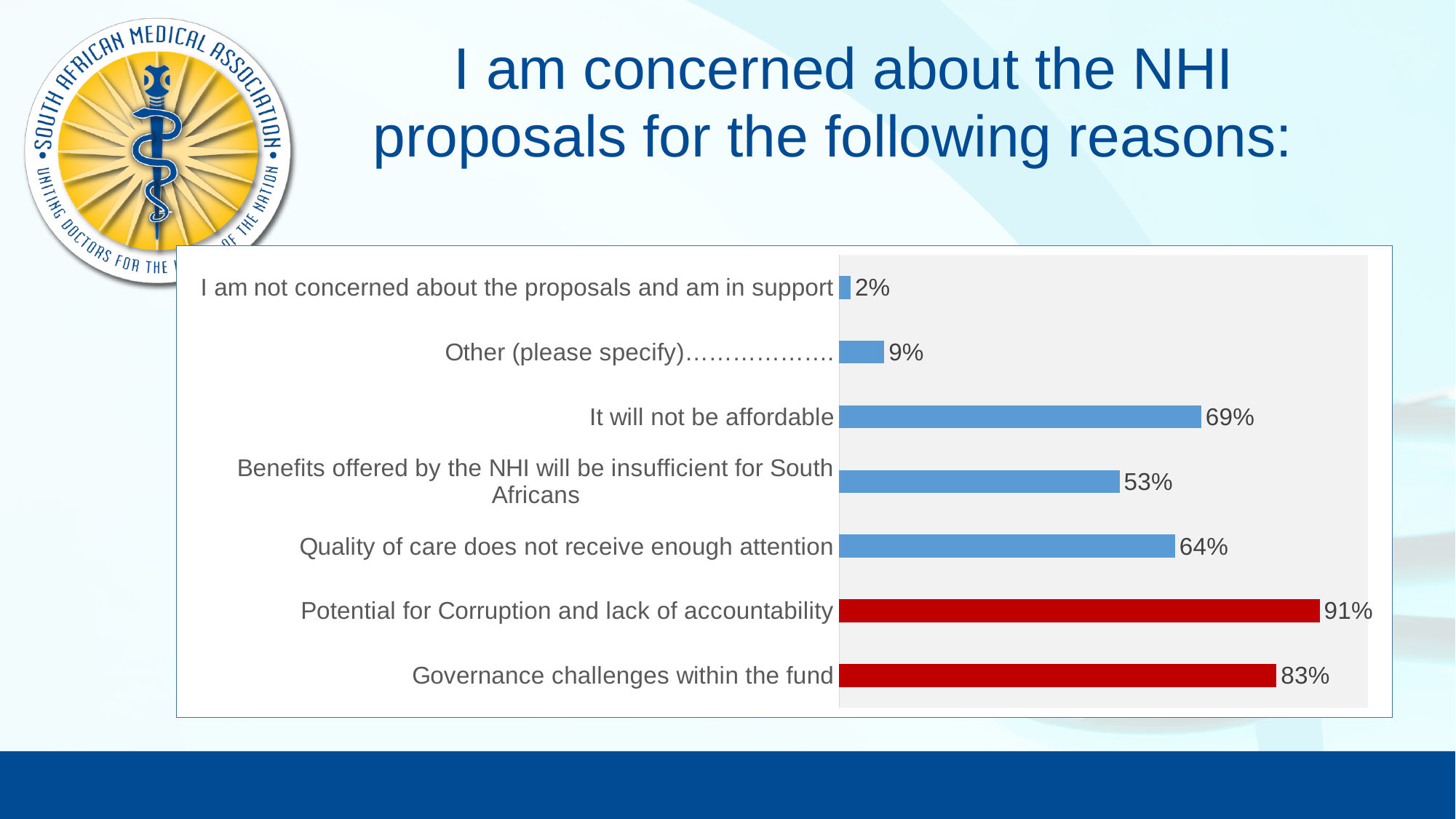
What kind of chart is shown on the slide? Bar chart How many categories are shown on the chart? 7 What is the difference between the values for "It will not be affordable" and "Other (please specify)"? 60% What is the difference between the percentages for "Potential for Corruption and lack of accountability" and "Governance challenges within the fund"? 8% Which reason has the highest percentage on the chart? Potential for Corruption and lack of accountability What value is shown for "I am not concerned about the proposals and am in support"? 2% What is the value shown for "Governance challenges within the fund"? 83% What percentage is shown for "It will not be affordable"? 69% Which two categories are shown with red bars? Potential for Corruption and lack of accountability; Governance challenges within the fund What percentage of respondents cited "Potential for Corruption and lack of accountability" as a concern? 91% Which is larger: the value for "Quality of care does not receive enough attention" or the value for "Benefits offered by the NHI will be insufficient for South Africans"? Quality of care does not receive enough attention Which category has the lowest percentage on the chart? I am not concerned about the proposals and am in support